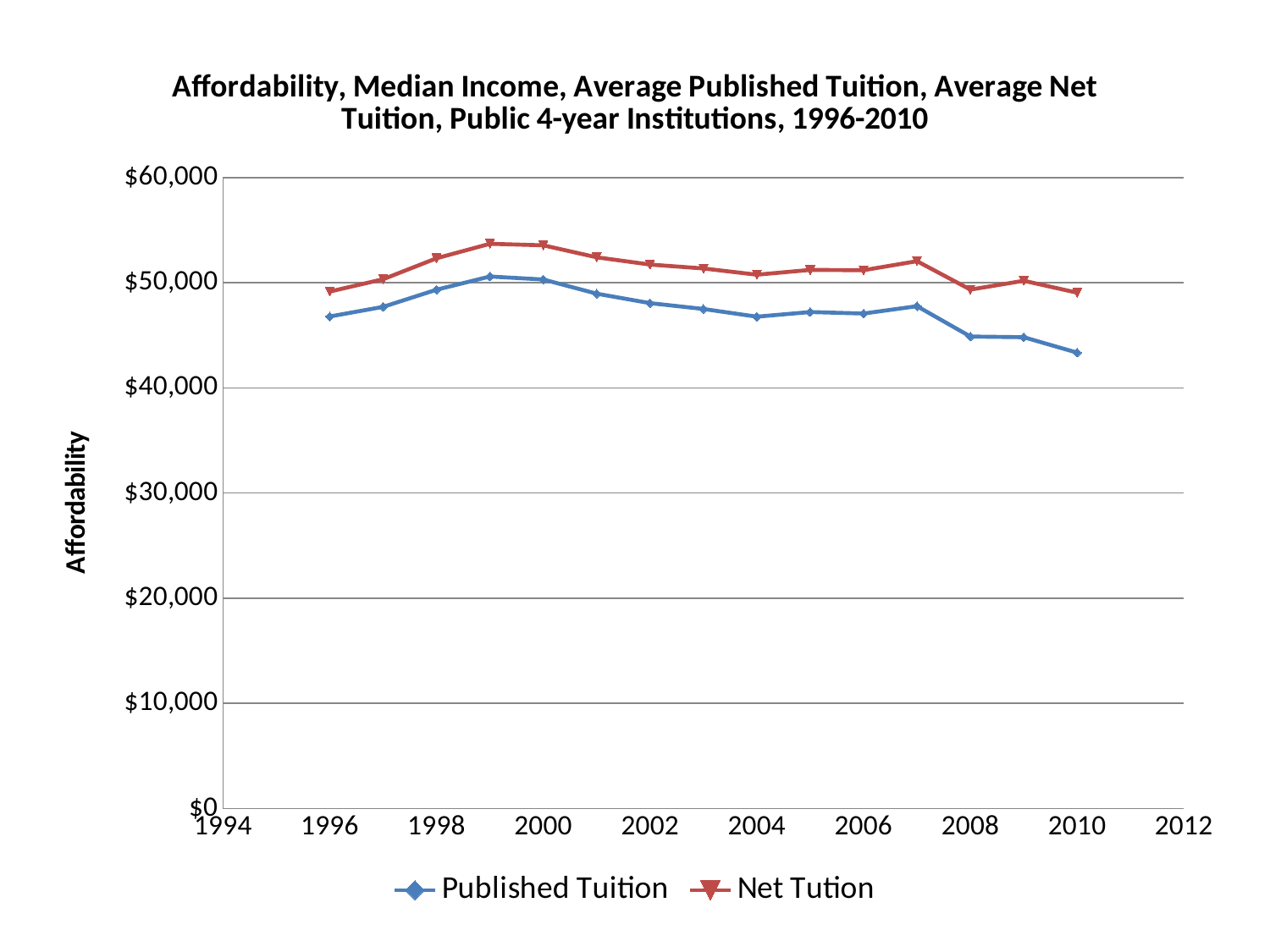
How many series does the legend list? 2 What is the label on the vertical axis? Affordability Is the value for Published Tuition in 1996 greater or less than $50,000? less In which year is the Published Tuition series at its lowest? 2010 Is the value for Published Tuition in 2010 greater or less than $50,000? less How many data points are plotted for the Published Tuition series? 15 What kind of chart is shown on the slide? line chart Is the value for Net Tution in 2000 greater or less than $50,000? greater Does the Published Tuition series rise or fall from 2007 to 2010? fall Which series is drawn in red? Net Tution In 2010, which series has the larger value, Published Tuition or Net Tution? Net Tution